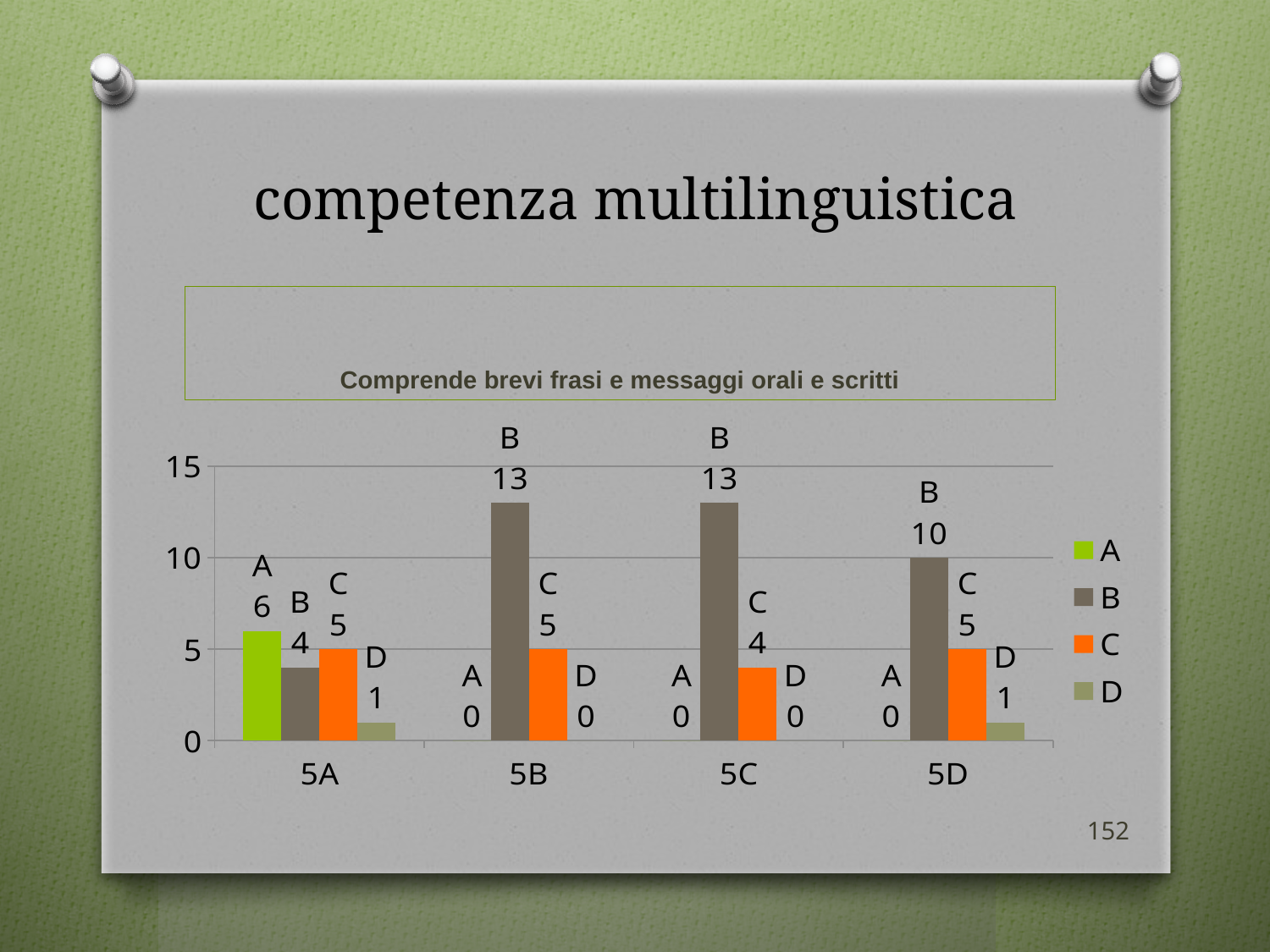
Which category has the lowest value for series B? 5A Which category has the highest value for series B? 5B and 5C What is the value for series A in category 5A? 6 How many series does the legend list? 4 What kind of chart is shown on the slide? bar chart How many categories are shown on the x axis? 4 Which is larger: the value for A in 5A or the value for B in 5A? A in 5A What is the value for series C in category 5C? 4 What is the difference between the value for B in 5B and the value for B in 5D? 3 What is the value for series B in category 5B? 13 What is the value for series D in category 5D? 1 Is the value for B in 5D greater or less than 5? greater